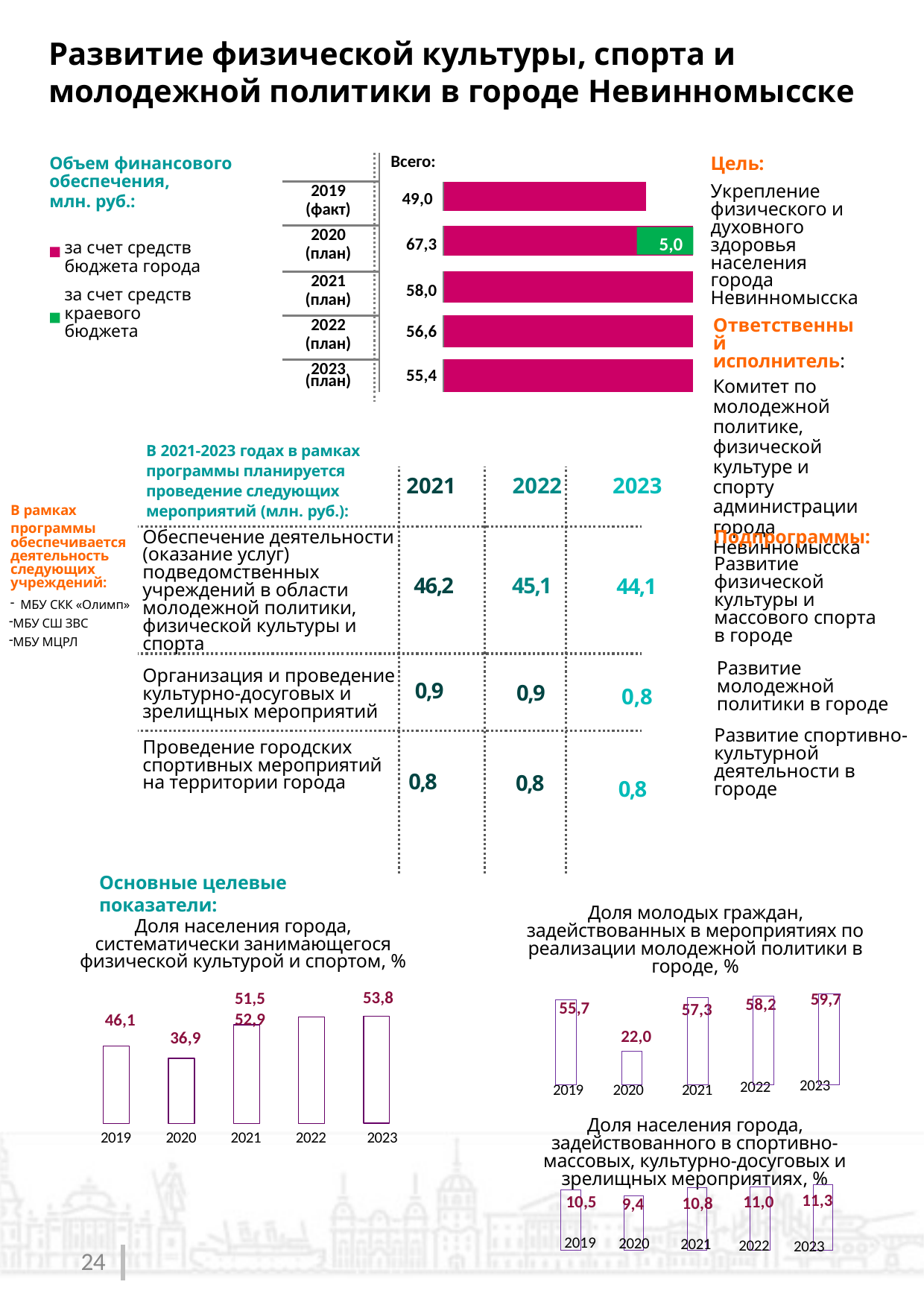
In the financial support chart at the top, which year has the highest total? 2020 (план) In the financial support chart at the top (Объем финансового обеспечения), what is the total value for 2019 (факт)? 49,0 What kind of chart is the financial support chart at the top of the slide? Bar chart In the financial support chart at the top, how many series does the legend list? 2 In the financial support chart at the top, which year has the lowest total? 2019 (факт) In the financial support chart at the top, what is the value of the regional budget (краевой бюджет) segment for 2020? 5,0 In the chart 'Доля населения города, задействованного в спортивно-массовых, культурно-досуговых и зрелищных мероприятиях, %', which year has the highest value? 2023 In the chart 'Доля молодых граждан, задействованных в мероприятиях по реализации молодежной политики в городе, %', what is the difference between the values for 2023 and 2022? 1,5 In the chart 'Доля населения города, систематически занимающегося физической культурой и спортом, %', what is the value for 2020? 36,9 In the chart 'Доля молодых граждан, задействованных в мероприятиях по реализации молодежной политики в городе, %', which year has the lowest value? 2020 In the financial support chart at the top, what is the difference between the totals for 2021 and 2022? 1,4 In the chart 'Доля населения города, систематически занимающегося физической культурой и спортом, %', which year has the lowest value? 2020